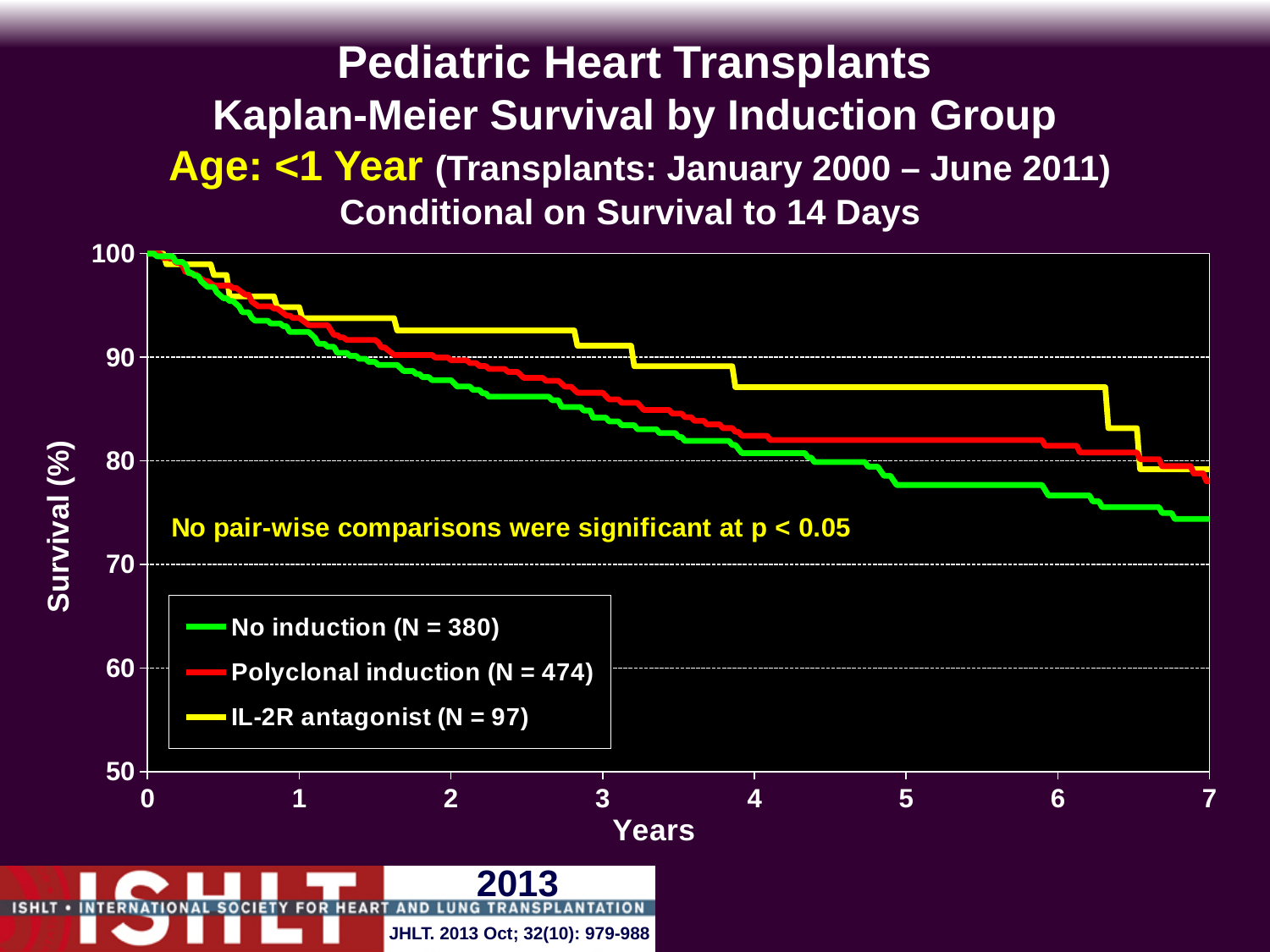
Do the survival curves rise or fall as years increase? fall Is the survival value for the No induction group at 3 years greater or less than 90? less What is the N for the IL-2R antagonist group shown in the legend? 97 What kind of chart is shown on the slide? line chart At 5 years, which group has higher survival: IL-2R antagonist or No induction? IL-2R antagonist At 7 years, which group has the lowest survival? No induction How many series does the legend list? 3 Is the survival value for the No induction group at 7 years greater or less than 80? less Is the survival value for the Polyclonal induction group at 5 years greater or less than 80? greater What is the N for the Polyclonal induction group shown in the legend? 474